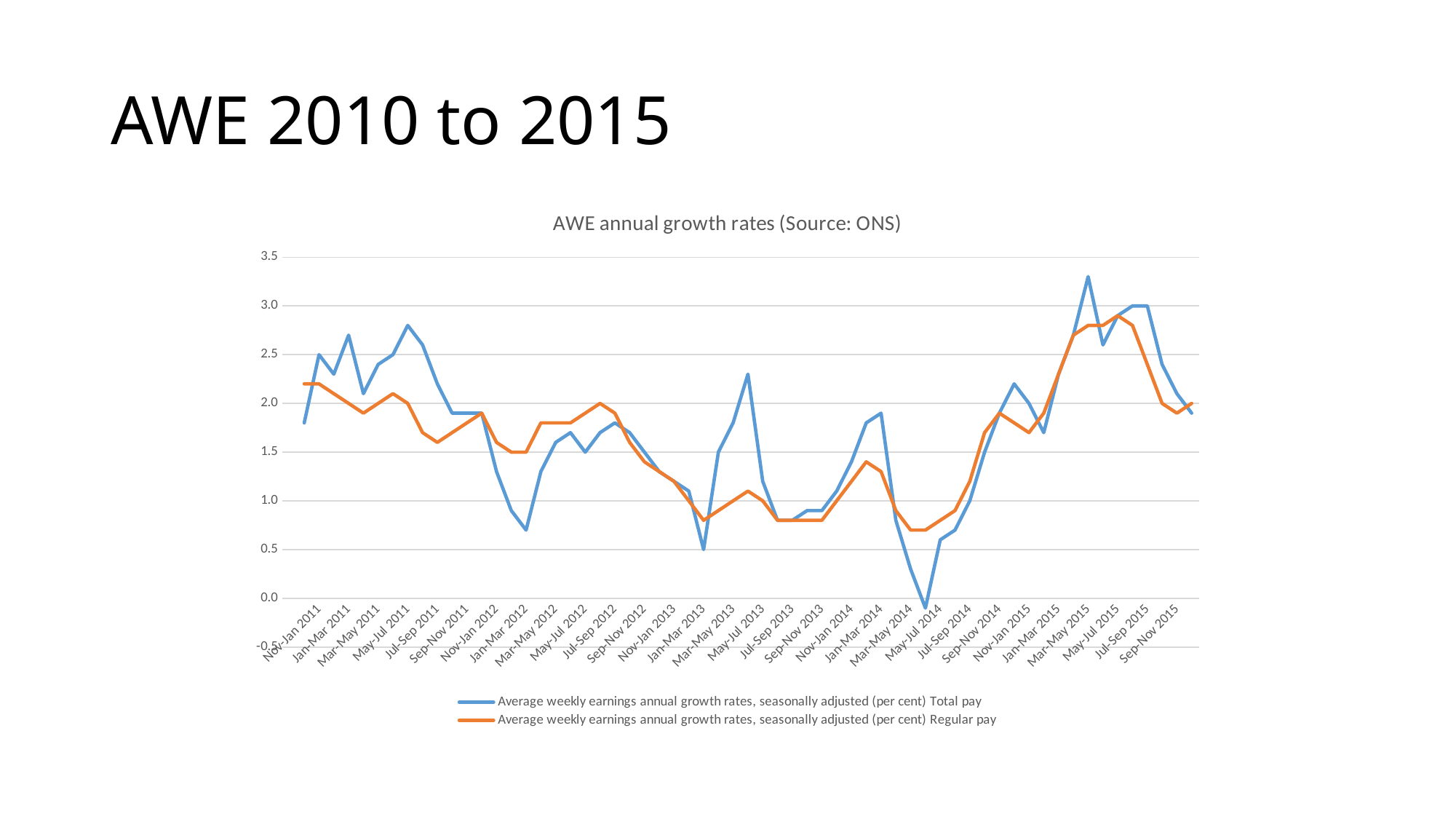
Which colour is used for the Total pay series? Blue Is the Regular pay value at Nov-Jan 2011 greater or less than 2.0? greater What is the title of the chart? AWE annual growth rates (Source: ONS) At May-Jul 2013, which series has the higher value, Total pay or Regular pay? Total pay Does the Total pay series rise or fall between Jan-Mar 2015 and May-Jul 2015? Rise What kind of chart is shown on the slide? Line chart How many series does the legend list? 2 Is the Total pay value at Jan-Mar 2012 greater or less than 1.0? less At Jan-Mar 2012, which series has the higher value, Total pay or Regular pay? Regular pay Around which period does the Total pay series reach its highest value? Mar-May 2015